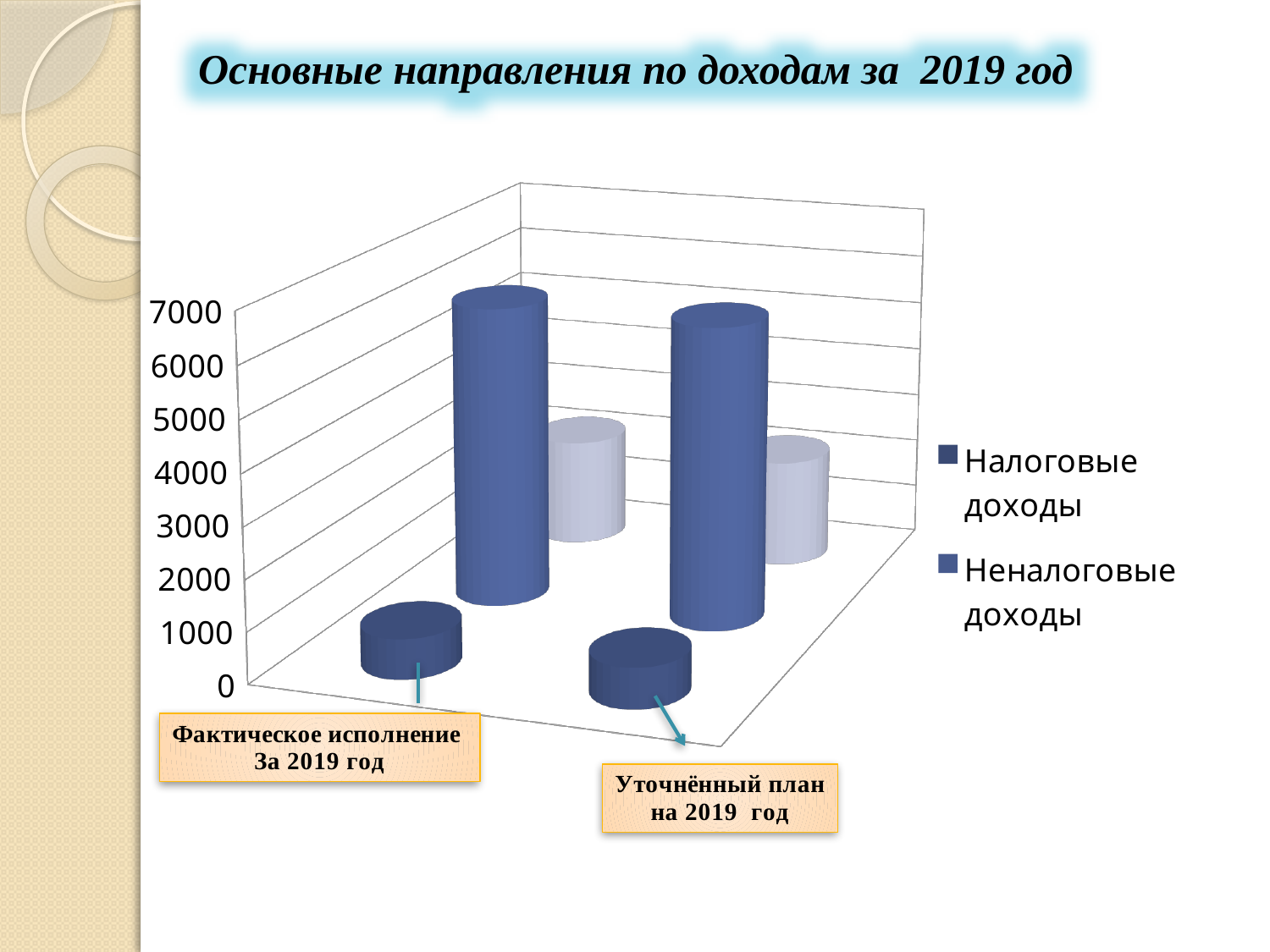
What are the two series named in the legend? Налоговые доходы and Неналоговые доходы For Уточнённый план на 2019 год, which is larger: Налоговые доходы or Неналоговые доходы? Неналоговые доходы Is the value of Налоговые доходы for Фактическое исполнение за 2019 год greater or less than 4000? less For Фактическое исполнение за 2019 год, which is larger: Налоговые доходы or Неналоговые доходы? Неналоговые доходы What is the title of the slide containing the chart? Основные направления по доходам за 2019 год How many series does the legend list? 2 How many categories are shown on the x axis of the chart? 2 Is the value of Налоговые доходы for Уточнённый план на 2019 год greater or less than 3000? less Which series has the tallest bars in the chart? Неналоговые доходы What kind of chart is shown on the slide? bar chart Is the value of Неналоговые доходы for Фактическое исполнение за 2019 год greater or less than 1000? greater